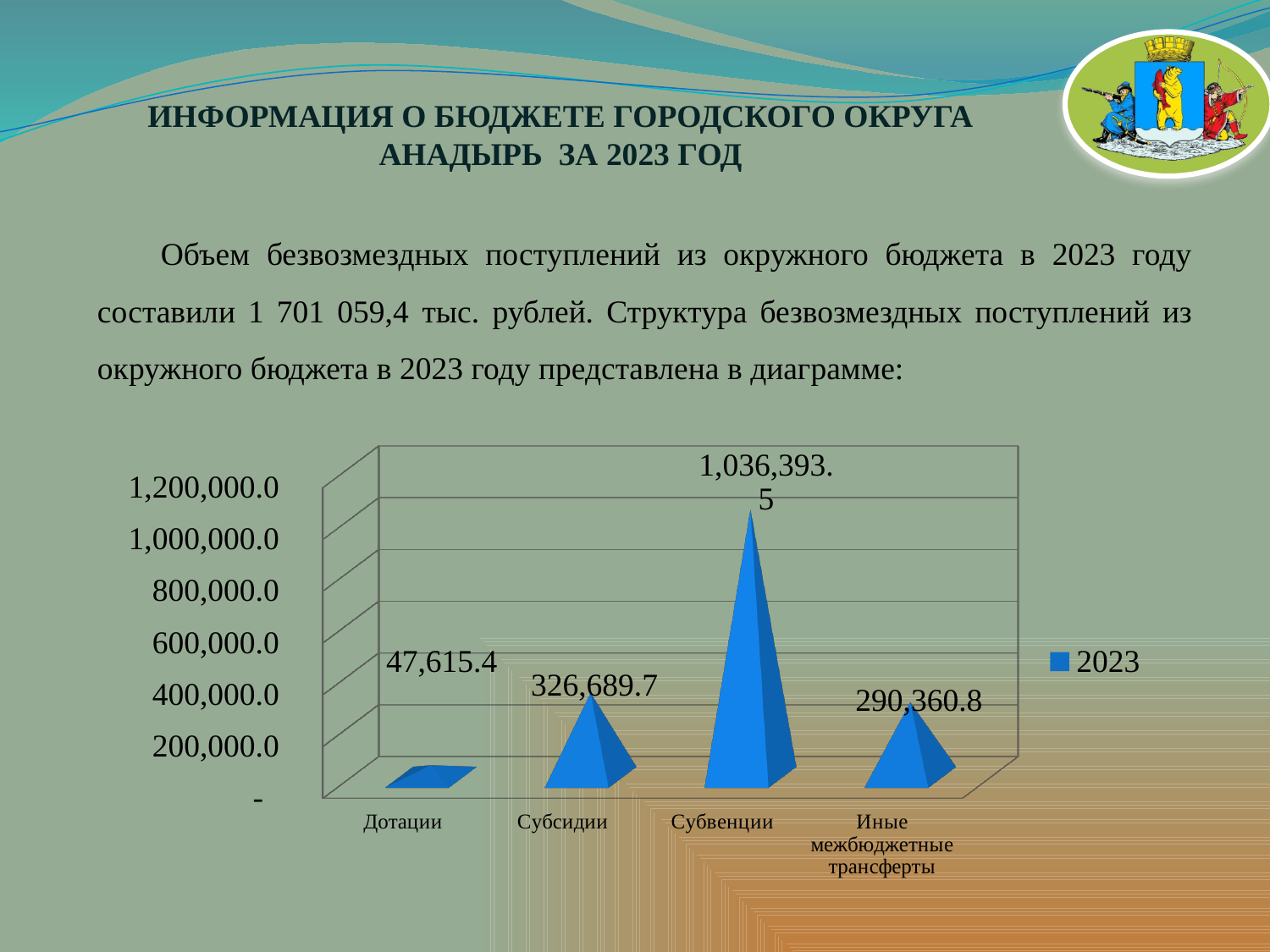
What is the value for Субвенции? 1,036,393.5 Is the value for Субвенции greater or less than 1,000,000.0? greater What kind of chart is shown on the slide? bar chart What is the value for Дотации? 47,615.4 What is the value for Субсидии? 326,689.7 How many series does the legend list? 1 Which category has the highest value? Субвенции Which category has the lowest value? Дотации What is the difference between the values for Субвенции and Субсидии? 709,703.8 How many categories are shown on the x axis? 4 What is the value for Иные межбюджетные трансферты? 290,360.8 Which is larger, the value for Субсидии or the value for Иные межбюджетные трансферты? Субсидии